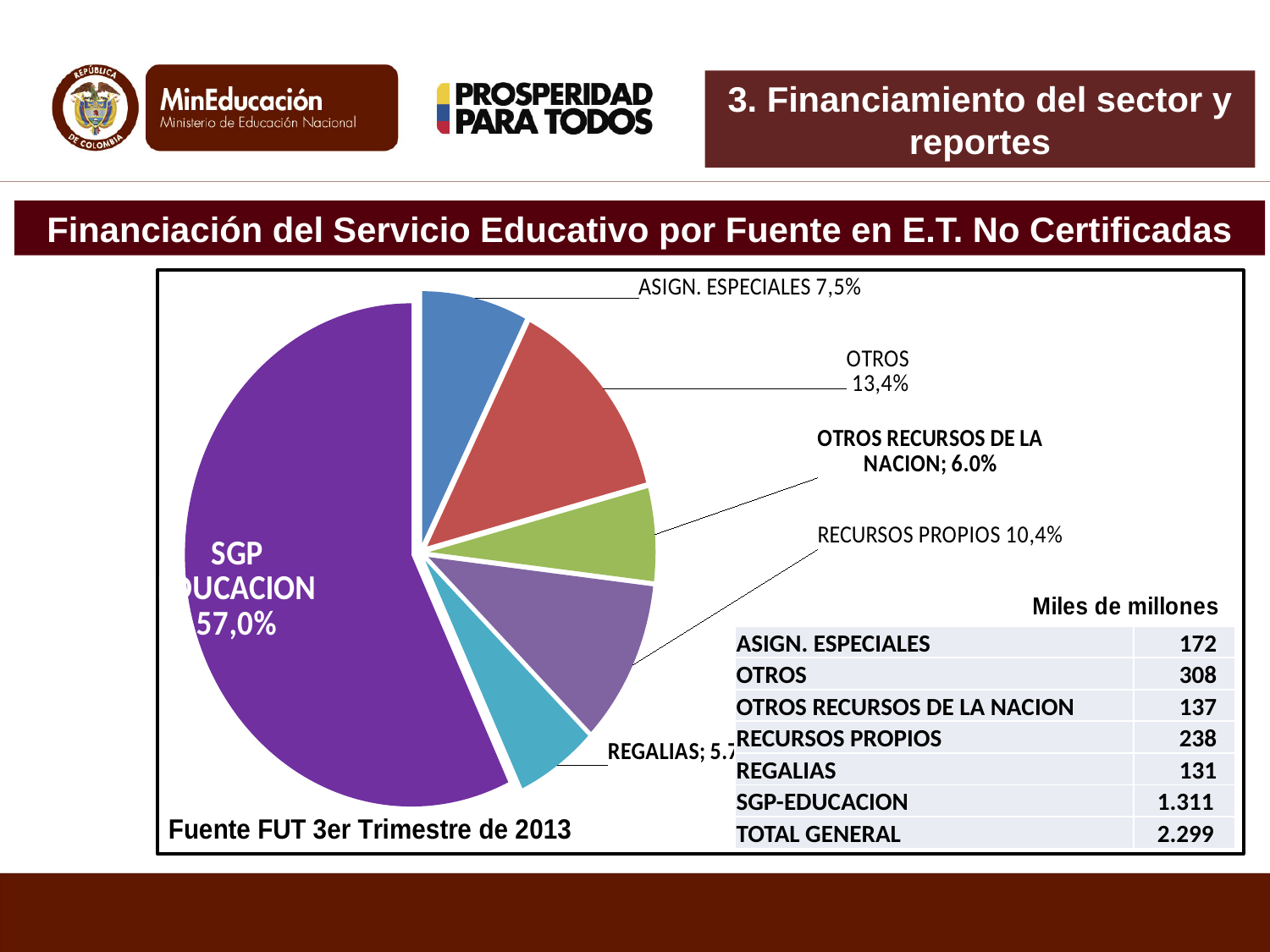
What is the value in miles de millones for OTROS RECURSOS DE LA NACION in the table? 137 Which source has the smallest value in the table? REGALIAS What kind of chart is shown on the slide? pie chart What share of the pie does ASIGN. ESPECIALES represent? 7,5% What share of the pie does OTROS represent? 13,4% How many slices does the pie chart have? 6 Which source has the largest slice of the pie? SGP EDUCACION What is the difference in miles de millones between OTROS and ASIGN. ESPECIALES? 136 What share of the pie does SGP EDUCACION represent? 57,0% What is the TOTAL GENERAL shown in the table? 2.299 What is the value in miles de millones for SGP-EDUCACION in the table? 1.311